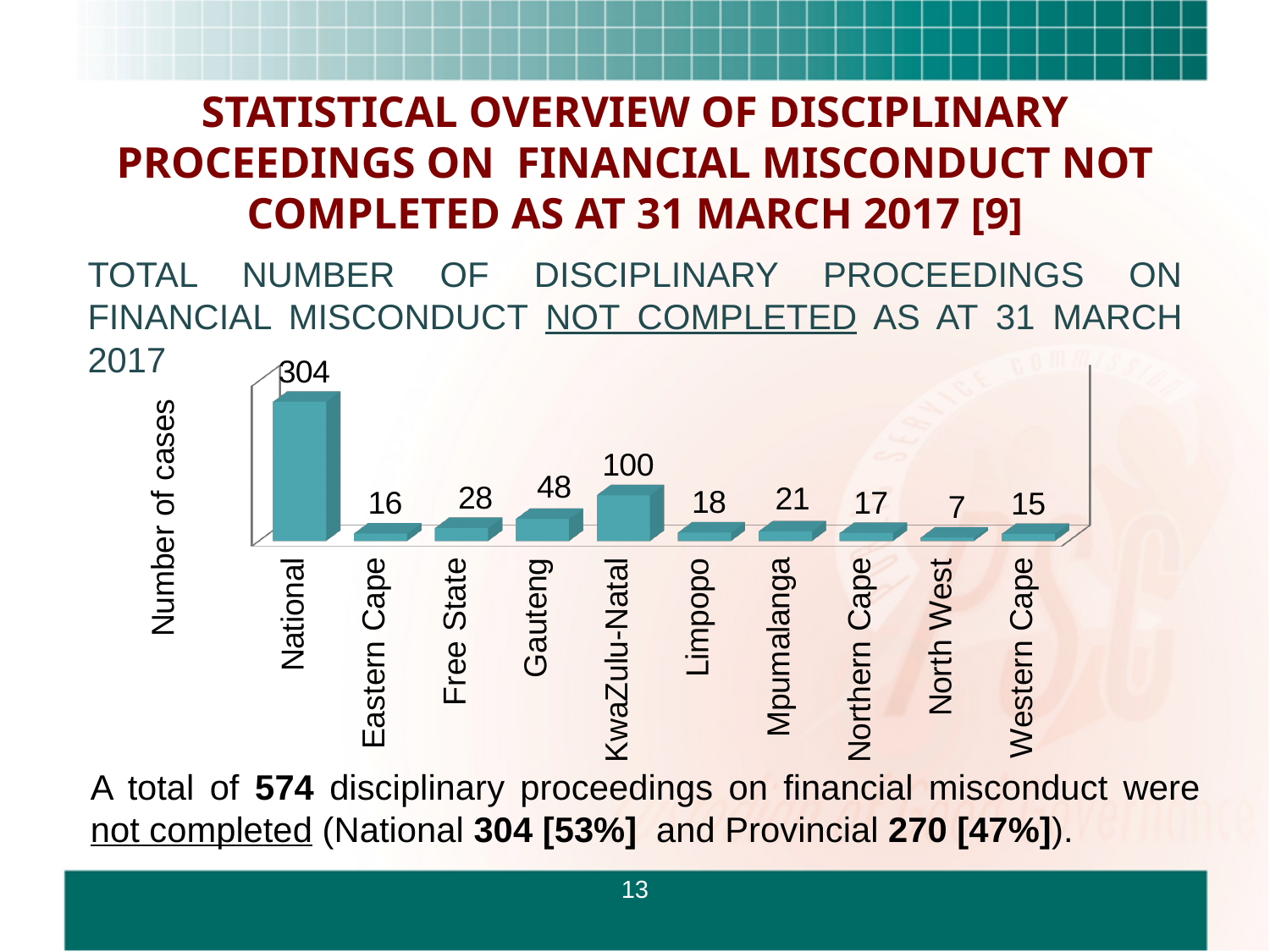
What is the number of cases for Mpumalanga? 21 Which category has the highest number of cases? National Which province has the highest number of cases among the provinces (excluding National)? KwaZulu-Natal What is the number of cases for KwaZulu-Natal? 100 What is the difference in number of cases between National and KwaZulu-Natal? 204 What is the label of the vertical axis of the chart? Number of cases What is the number of cases for Gauteng? 48 How many categories are shown on the x axis of the chart? 10 What kind of chart is shown on the slide? Bar chart Which has more cases, Limpopo or Western Cape? Limpopo Which category has the lowest number of cases? North West What is the difference in number of cases between Free State and Eastern Cape? 12